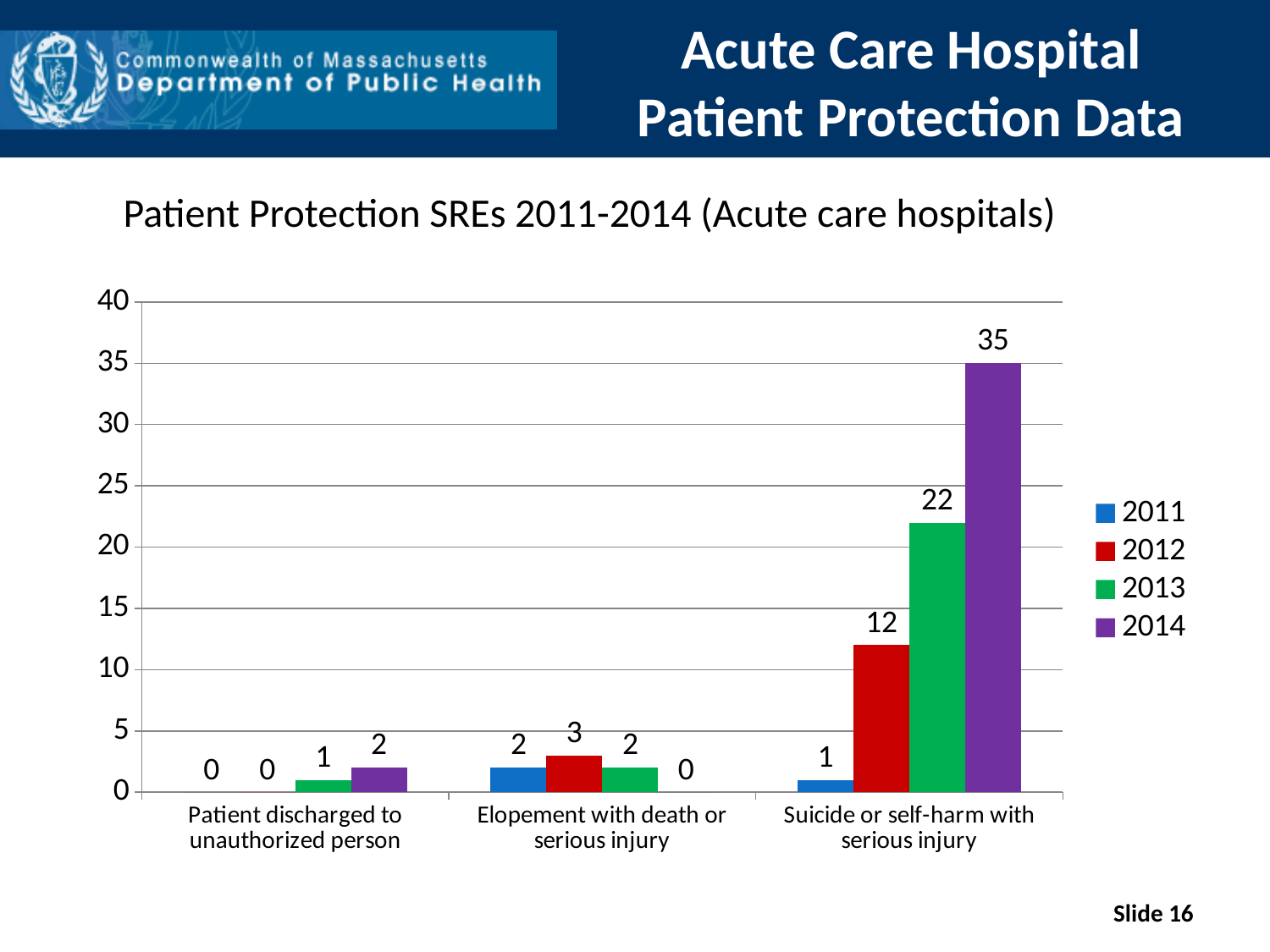
How many categories are shown on the x axis? 3 What is the title of the chart? Patient Protection SREs 2011-2014 (Acute care hospitals) How many series does the legend list? 4 What is the value for 2012 in the Elopement with death or serious injury category? 3 Which category has the lowest value for 2012? Patient discharged to unauthorized person What kind of chart is shown on the slide? Bar chart What is the difference between the 2014 and 2013 values in the Suicide or self-harm with serious injury category? 13 What is the value for 2013 in the Patient discharged to unauthorized person category? 1 Which category has the highest value for 2014? Suicide or self-harm with serious injury What is the value for 2014 in the Suicide or self-harm with serious injury category? 35 Which is larger in the Elopement with death or serious injury category, the 2012 value or the 2013 value? 2012 What is the value for 2011 in the Suicide or self-harm with serious injury category? 1